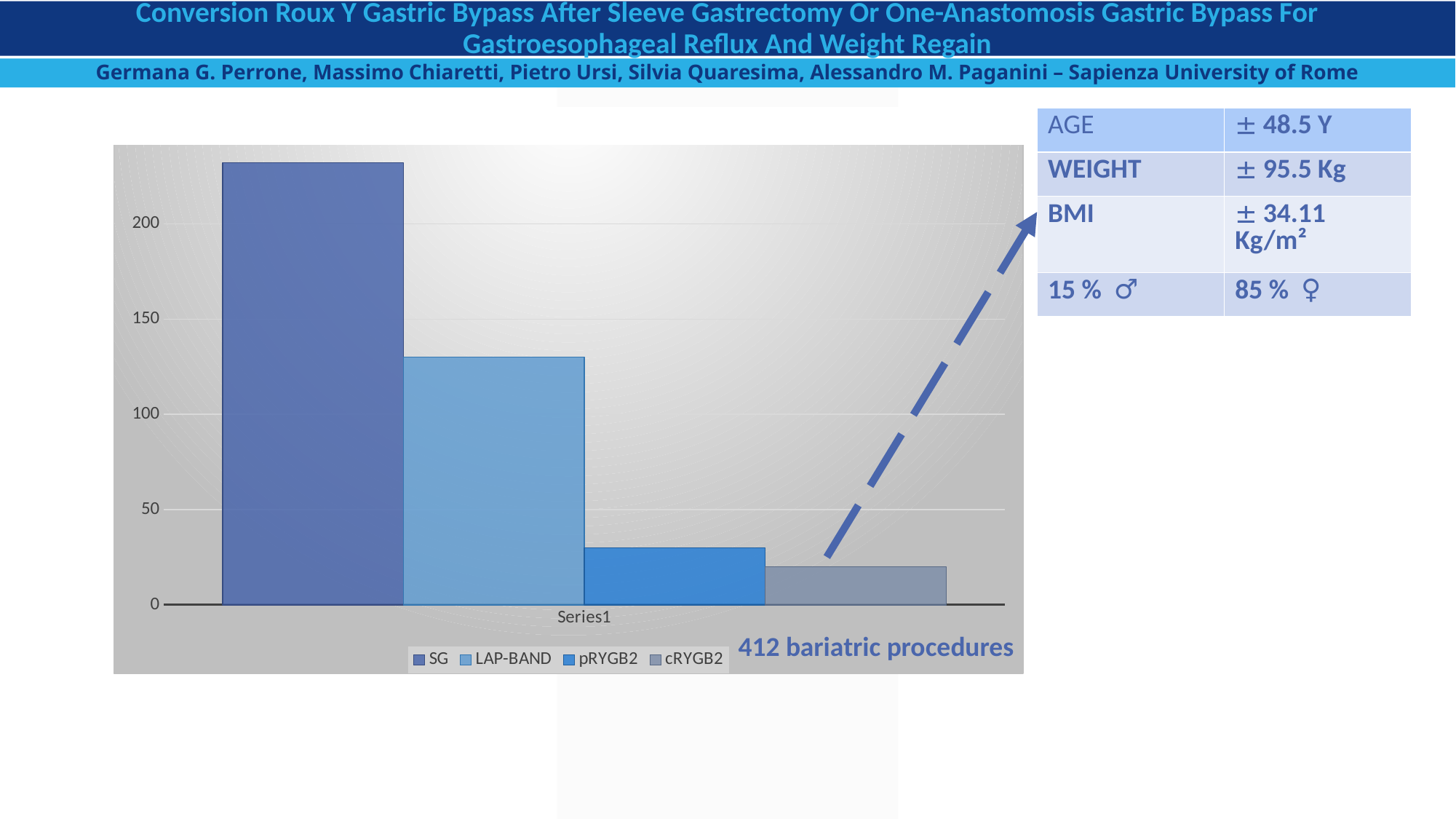
Is the value for LAP-BAND greater or less than 150? less Which is larger in the chart, the bar for pRYGB2 or the bar for LAP-BAND? LAP-BAND How many bars are plotted in the chart? 4 Which series has the shortest bar in the chart? cRYGB2 Is the value for LAP-BAND greater or less than 100? greater Is the value for pRYGB2 greater or less than 50? less What kind of chart is shown on the slide? bar chart Which is larger in the chart, the bar for SG or the bar for LAP-BAND? SG What label is shown on the category axis of the chart? Series1 How many series does the chart legend list? 4 Which series has the tallest bar in the chart? SG